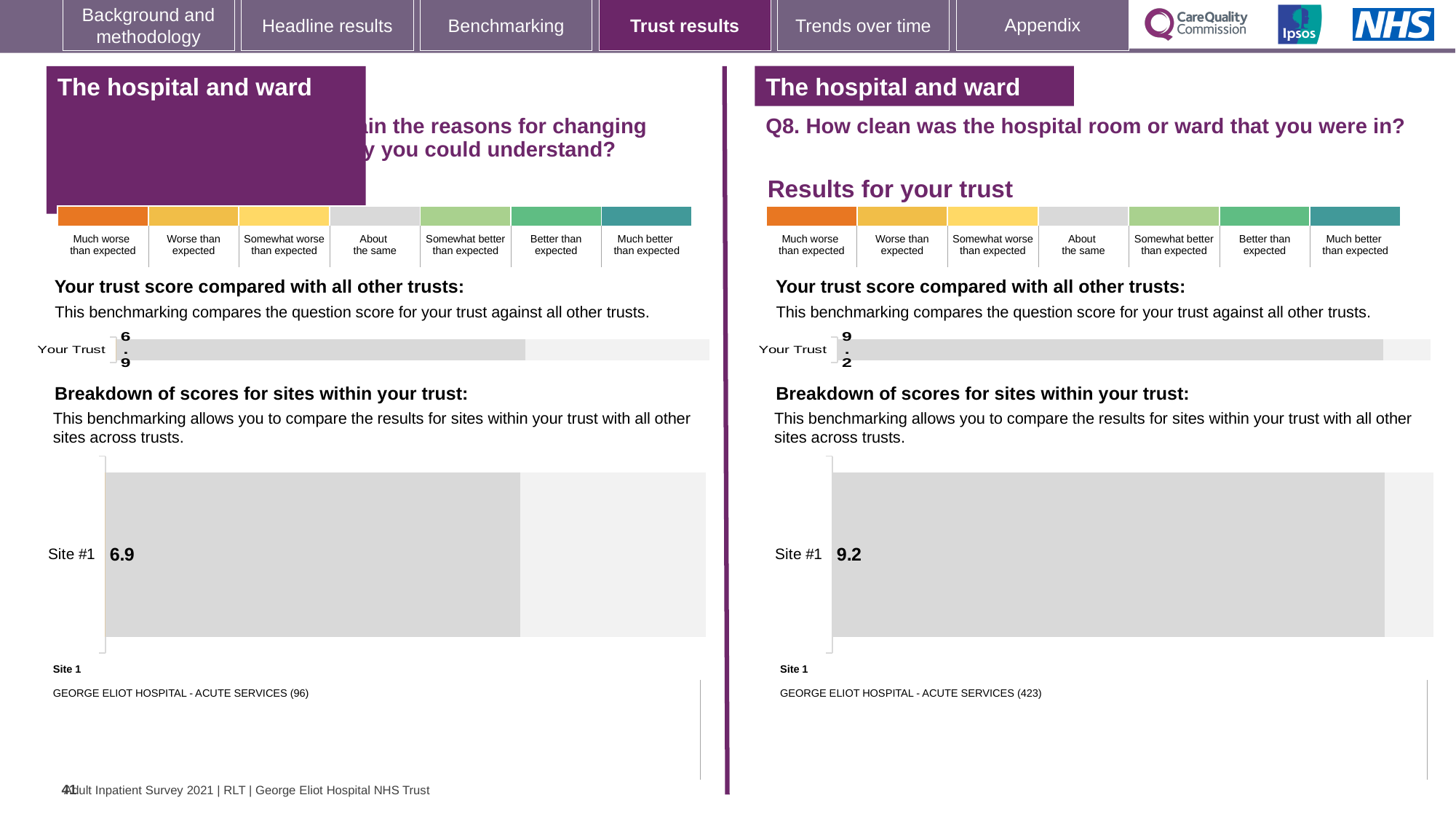
What is the difference between the Site #1 score on the right-hand panel (Q8) and the Site #1 score on the left-hand panel? 2.3 On the left-hand panel, what is the score shown for Your Trust? 6.9 How many sites are shown in the 'Breakdown of scores for sites within your trust' chart on the right-hand panel (Q8)? 1 On the right-hand panel (Q8), which site name is listed as Site 1 below the chart? GEORGE ELIOT HOSPITAL - ACUTE SERVICES (423) On the right-hand panel (Q8), what is the score shown for Site #1? 9.2 On the left-hand panel, what is the score shown for Site #1? 6.9 What type of chart is used to show the Site #1 score on the right-hand panel (Q8)? Bar chart How many sites are shown in the 'Breakdown of scores for sites within your trust' chart on the left-hand panel? 1 Which is larger: the Site #1 score on the left-hand panel or the Site #1 score on the right-hand panel (Q8)? Right-hand panel (Q8) On the left-hand panel, which site name is listed as Site 1 below the chart? GEORGE ELIOT HOSPITAL - ACUTE SERVICES (96) On the right-hand panel (Q8. How clean was the hospital room or ward that you were in?), what is the score shown for Your Trust? 9.2